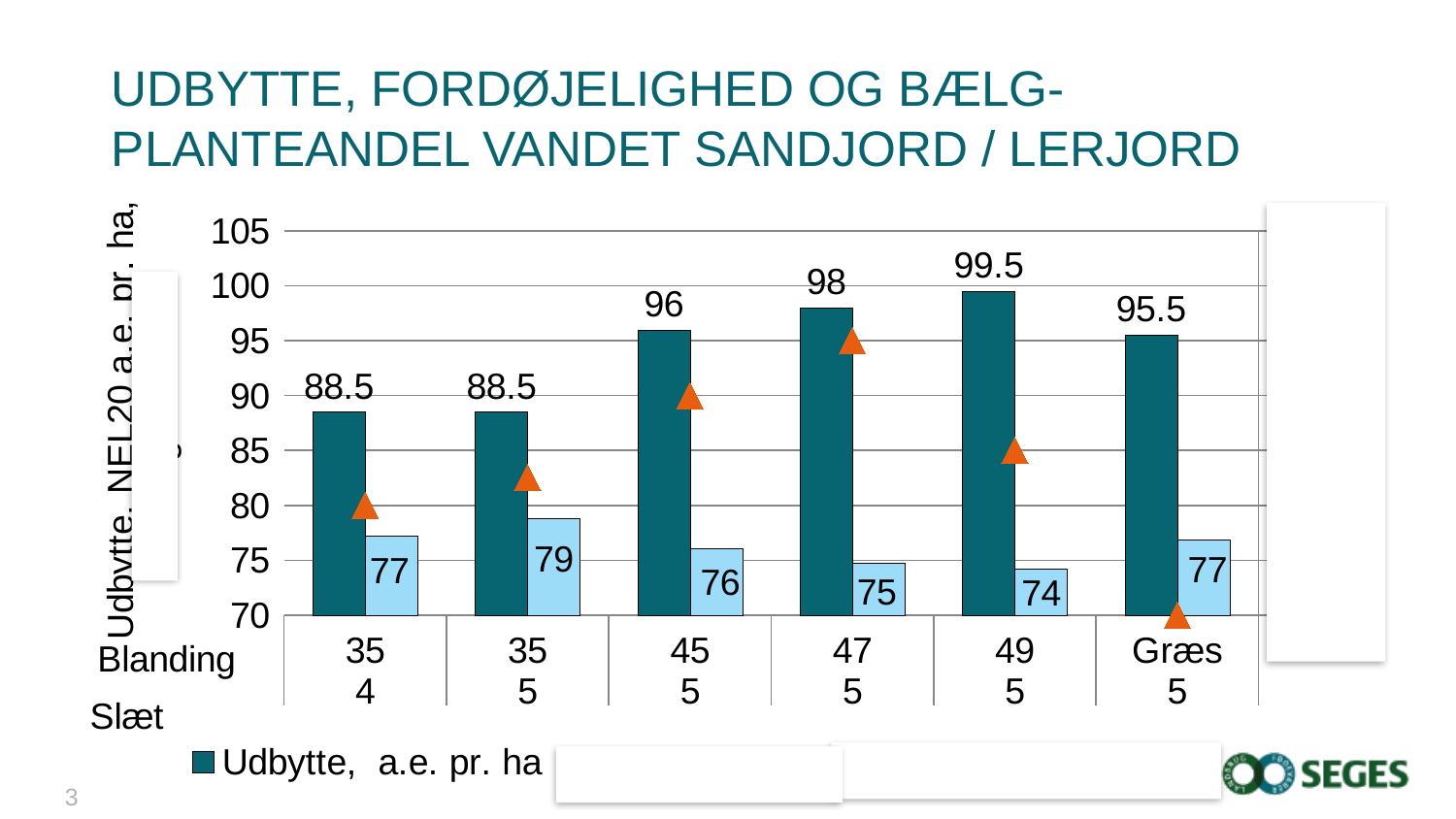
Is the orange triangle marker for Blanding 47, Slæt 5 greater or less than 90? greater What is the Udbytte, a.e. pr. ha value for Græs, Slæt 5? 95.5 What type of chart is used for the Udbytte, a.e. pr. ha series? bar chart Which category has the highest Udbytte, a.e. pr. ha value? 49 / 5 How many categories are shown on the x axis? 6 What is the Udbytte, a.e. pr. ha value for Blanding 47, Slæt 5? 98 What is the difference in Udbytte, a.e. pr. ha between Blanding 49, Slæt 5 and Blanding 35, Slæt 4? 11 Which has a higher Udbytte, a.e. pr. ha value: Blanding 45, Slæt 5 or Græs, Slæt 5? 45 / 5 Which category has the lowest value on the light blue bars? 49 / 5 Is the orange triangle marker for Blanding 35, Slæt 4 greater or less than 85? less What value is shown on the light blue bar for Blanding 35, Slæt 5? 79 What is the label of the dark teal series in the legend? Udbytte, a.e. pr. ha